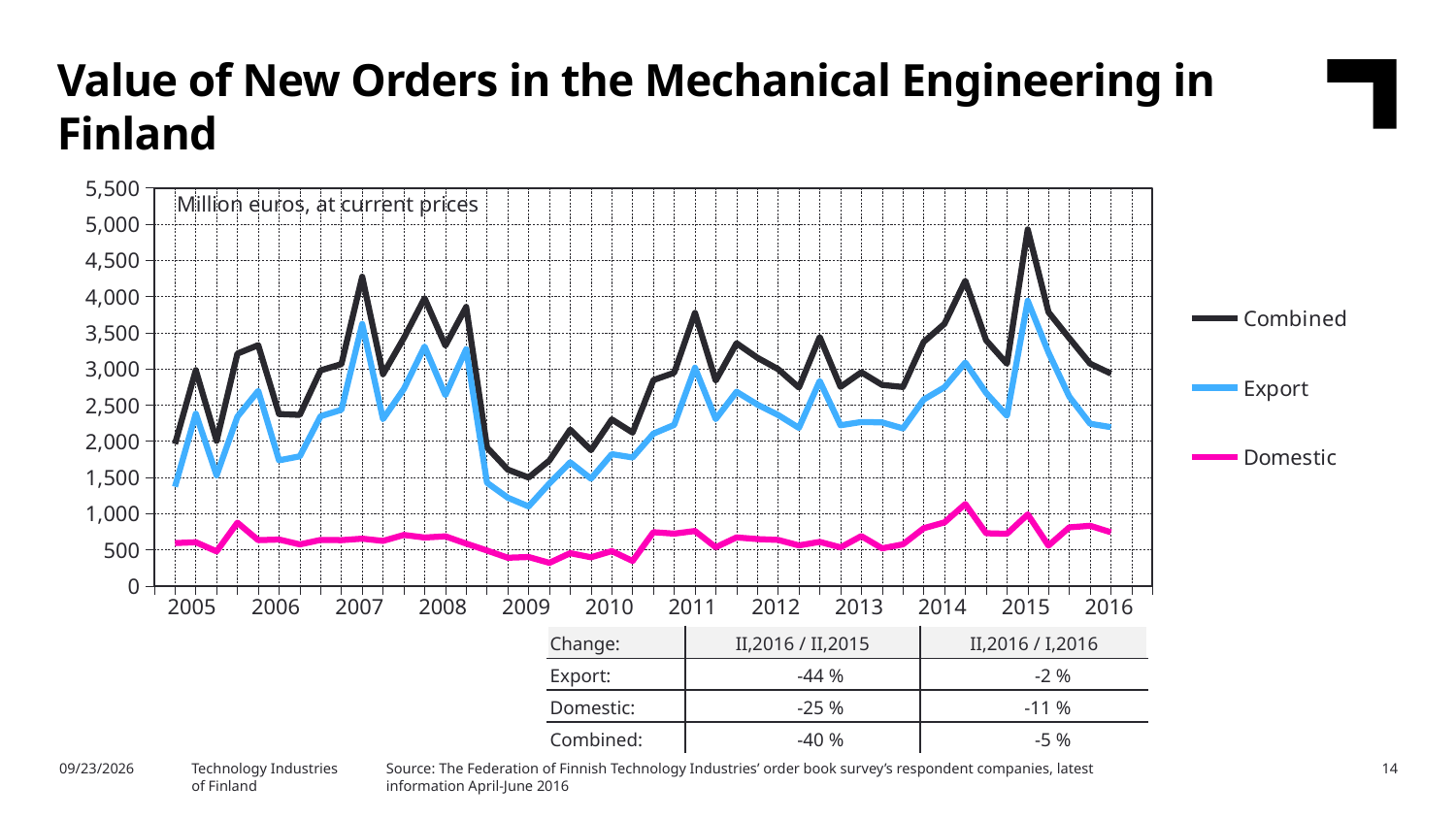
Is the Domestic value in 2009 greater or less than 1,000? less What unit is stated in the label inside the chart area? Million euros, at current prices Which series has the highest values throughout the chart? Combined Which series has the lowest values throughout the chart? Domestic Is the peak value of the Combined series in 2015 greater or less than 4,500? greater Does the Combined series rise or fall from its 2015 peak to 2016? Fall Is the peak value of the Export series in 2015 greater or less than 3,500? greater What type of chart is shown on the slide? Line chart How many series does the legend list? 3 What are the three series named in the legend? Combined, Export, Domestic Which is larger in 2016, the Export series or the Domestic series? Export